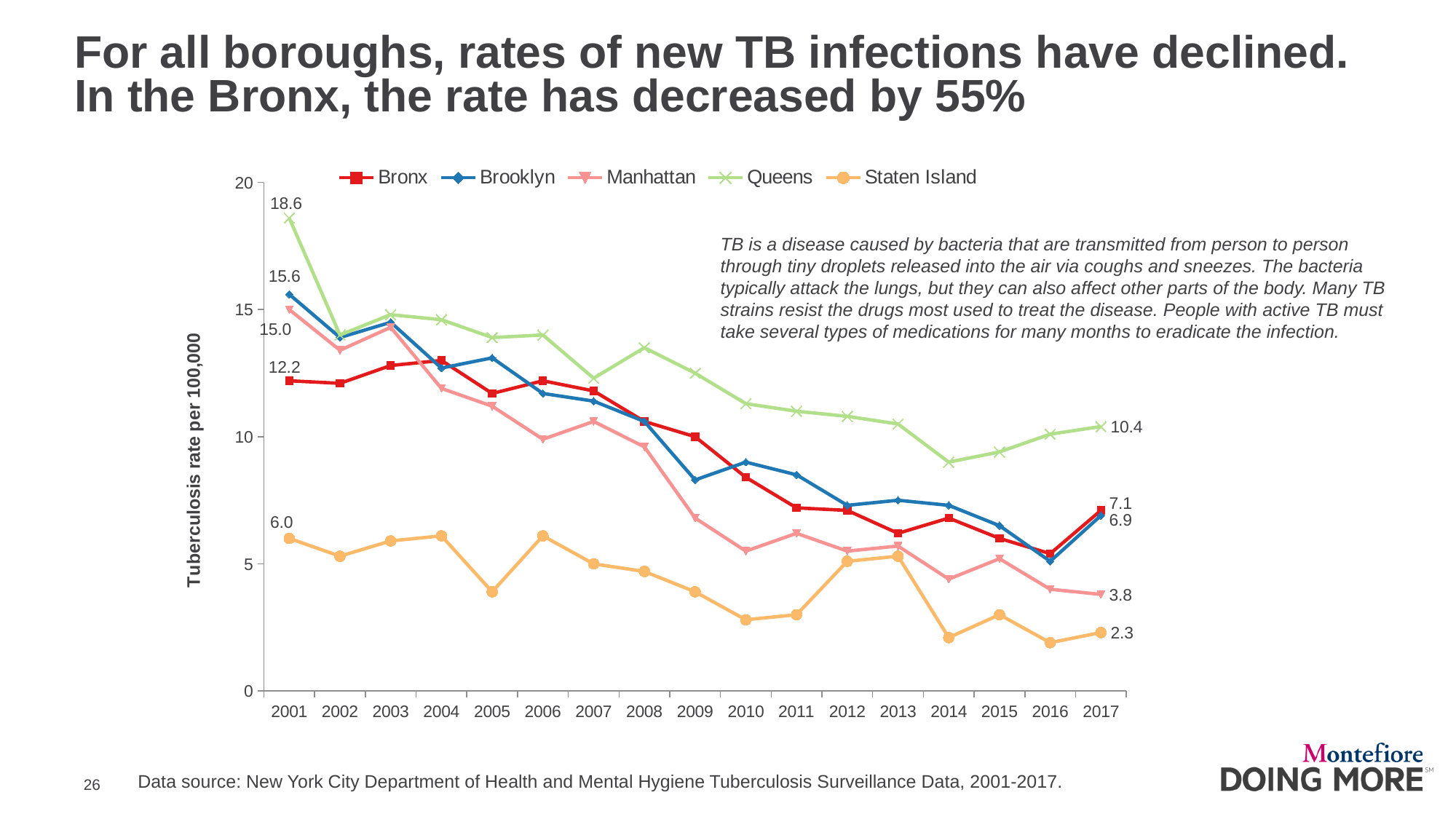
Overall, do the tuberculosis rates rise or fall from 2001 to 2017? Fall What was the tuberculosis rate per 100,000 in Staten Island in 2001? 6.0 How many series does the legend list? 5 Which borough had the highest tuberculosis rate in 2017? Queens What was the tuberculosis rate per 100,000 in the Bronx in 2017? 7.1 How many years are shown on the x axis? 17 What was the tuberculosis rate per 100,000 in Queens in 2001? 18.6 Is the Queens tuberculosis rate in 2014 greater or less than 10? less By how much did the Bronx tuberculosis rate fall from 2001 (12.2) to 2017 (7.1)? 5.1 In 2017, which was higher: the Manhattan rate or the Staten Island rate? Manhattan Which borough had the lowest tuberculosis rate in 2001? Staten Island What type of chart is shown on the slide? Line chart